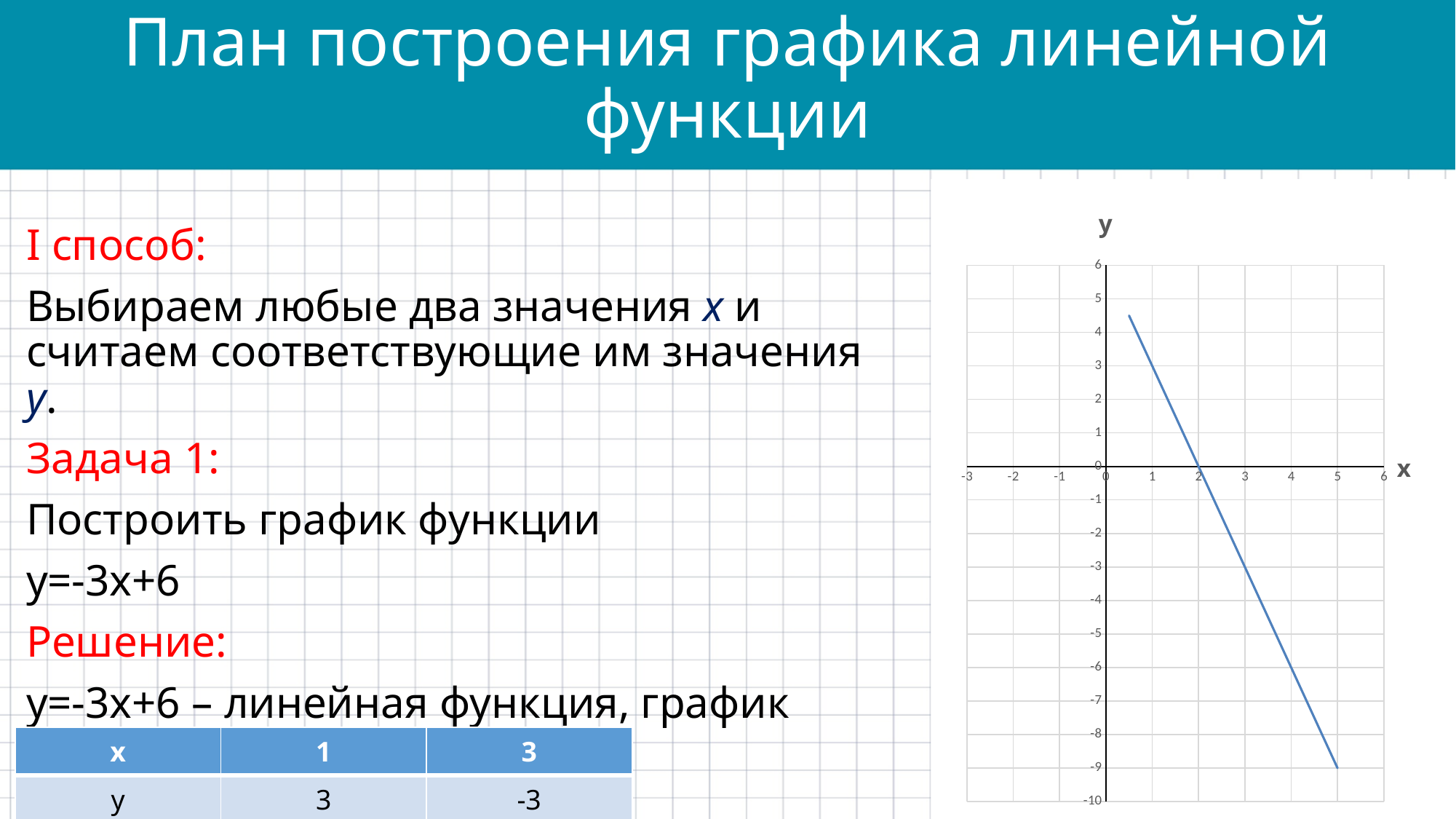
What kind of chart is shown on the right of the slide? line chart At x = 5, is the value of the line greater or less than -8? less At x = 1, is the value of the line greater or less than 2? greater How many lines are plotted on the chart? 1 What is the lowest value shown on the y axis of the chart? -10 At what x value does the plotted line cross the x axis? 2 At x = 3, is the value of the line greater or less than 0? less Which is larger: the value of the line at x = 1 or at x = 3? at x = 1 Does the line on the chart rise or fall as x increases? fall What is the highest value shown on the y axis of the chart? 6